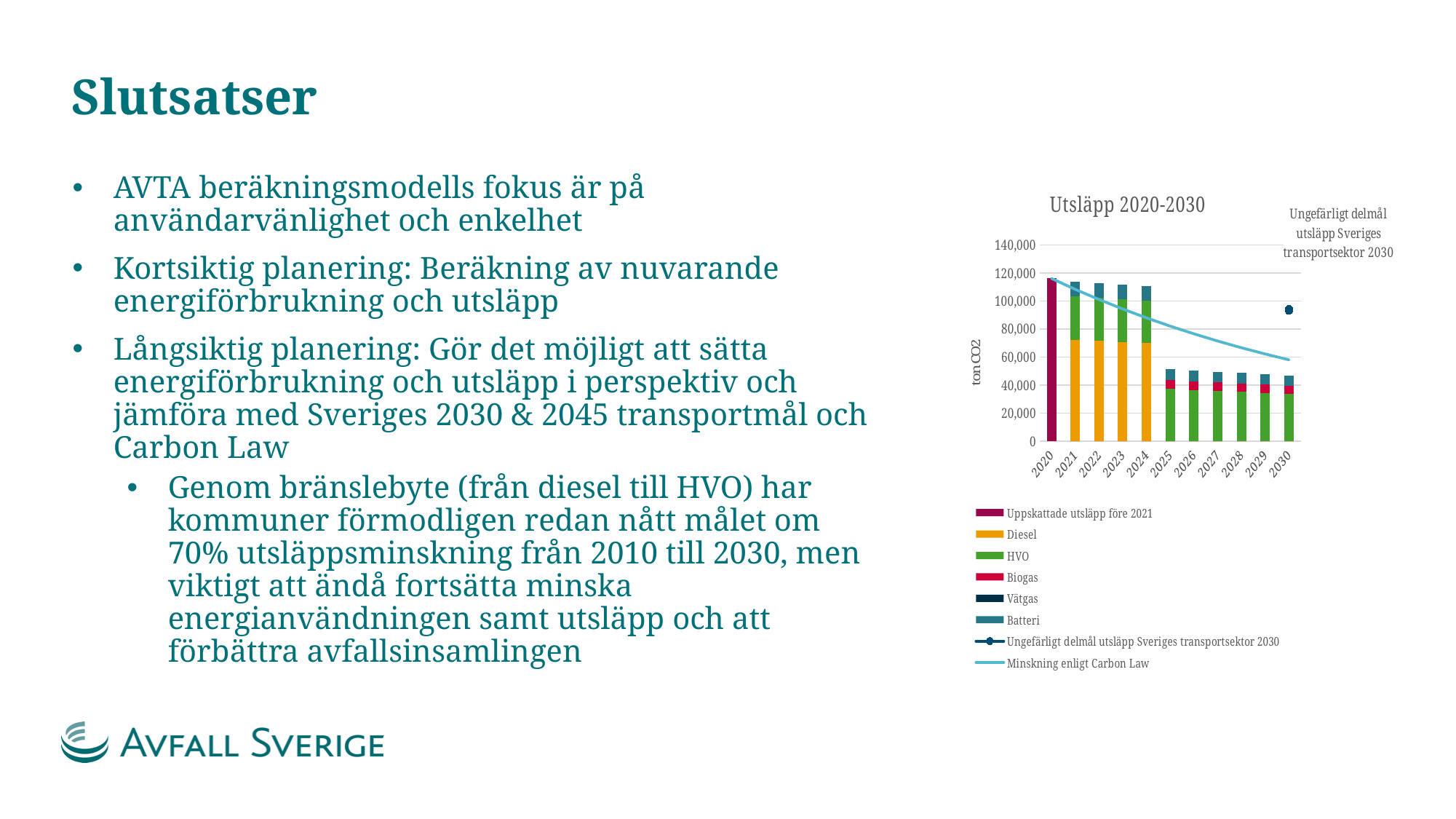
How many years are shown on the x axis of the chart? 11 What kind of chart is shown on the slide? Stacked bar chart with a line Do the total emissions bars rise or fall from 2020 to 2030? fall What is the title of the chart on the slide? Utsläpp 2020-2030 Is the total bar for 2030 greater or less than 40,000? greater Which year has the larger total bar, 2024 or 2025? 2024 Is the point for 'Ungefärligt delmål utsläpp Sveriges transportsektor 2030' greater or less than 80,000? greater Is the total bar for 2020 greater or less than 100,000? greater What is the label of the y axis of the chart? ton CO2 Which year has the highest total bar in the chart? 2020 How many entries does the chart's legend list? 8